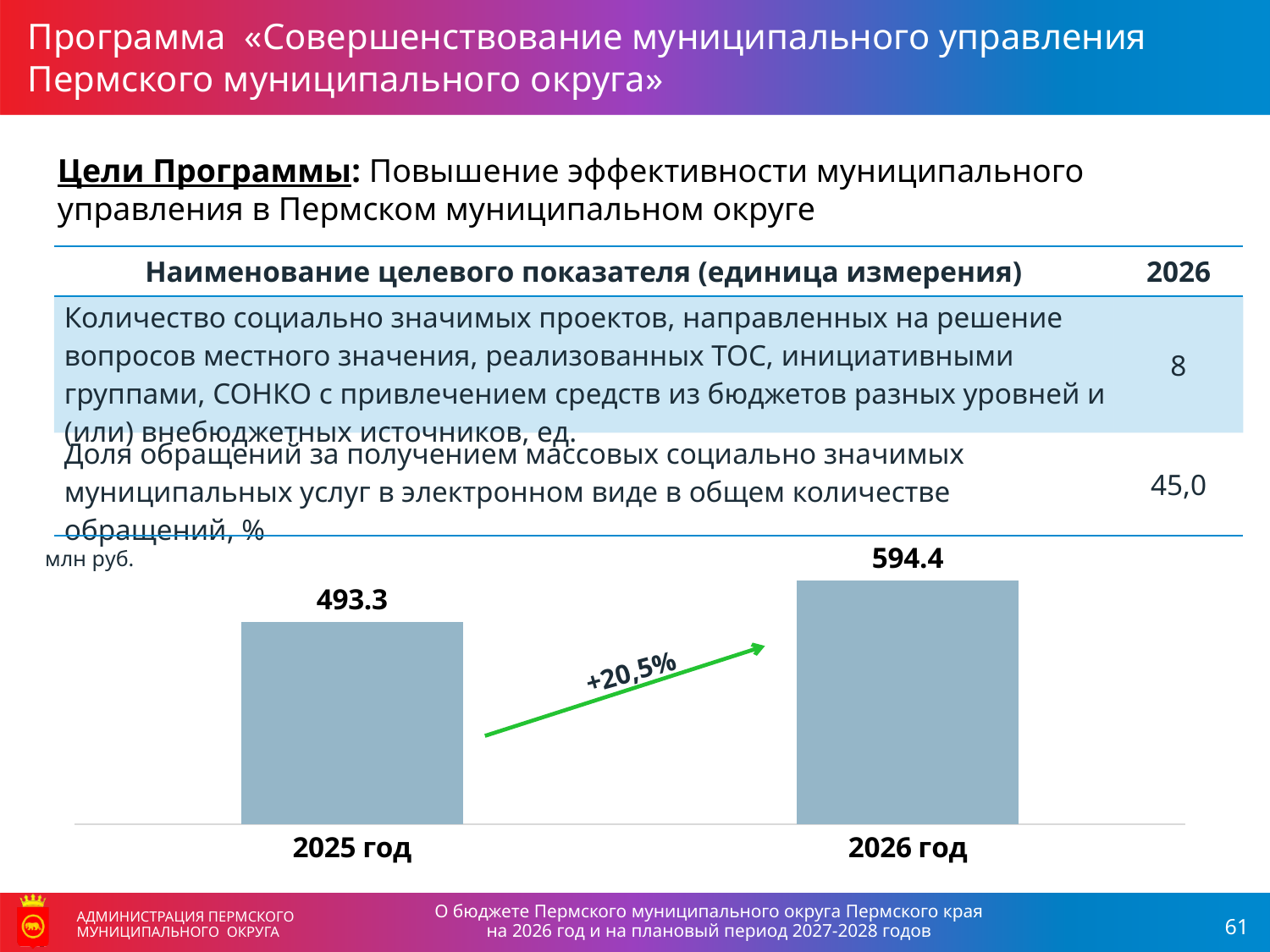
Do the values on the bar chart rise or fall from 2025 год to 2026 год? Rise What is the difference between the values for 2026 год and 2025 год on the bar chart? 101.1 Which year has the highest value on the bar chart? 2026 год What is the value for 2026 год on the bar chart? 594.4 How many bars are shown on the chart? 2 What kind of chart is shown on the slide? Bar chart What unit of measurement is indicated for the bar chart? млн руб. What percentage change is shown by the arrow between the two bars? +20,5% Which is larger on the bar chart: the value for 2025 год or for 2026 год? 2026 год What is the value for 2025 год on the bar chart? 493.3 Which year has the lowest value on the bar chart? 2025 год